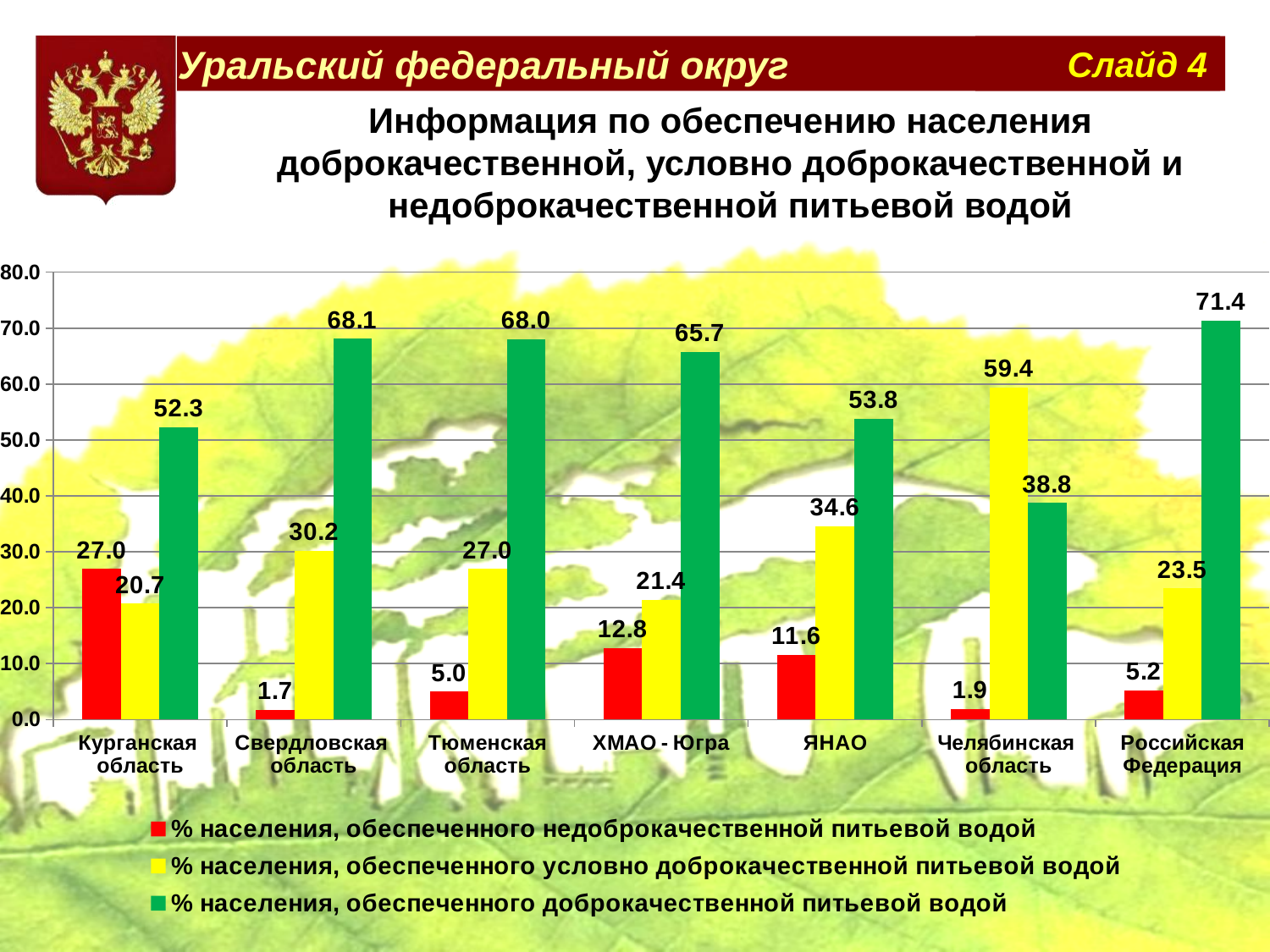
How many series does the chart legend list? 3 Is the value for Тюменская область in the series '% населения, обеспеченного доброкачественной питьевой водой' greater or less than 60.0? greater What is the value for ХМАО - Югра in the series '% населения, обеспеченного недоброкачественной питьевой водой'? 12.8 How many regions (categories) are shown on the x axis of the chart? 7 What colour represents the series '% населения, обеспеченного недоброкачественной питьевой водой' in the chart? red What is the value for Курганская область in the series '% населения, обеспеченного доброкачественной питьевой водой'? 52.3 What is the value for Челябинская область in the series '% населения, обеспеченного условно доброкачественной питьевой водой'? 59.4 Which category has the highest value in the series '% населения, обеспеченного доброкачественной питьевой водой'? Российская Федерация Which is larger: the '% населения, обеспеченного условно доброкачественной питьевой водой' value for ЯНАО or for Свердловская область? ЯНАО What type of chart is shown on the slide? bar chart What is the difference between the '% населения, обеспеченного доброкачественной питьевой водой' values for Российская Федерация and Челябинская область? 32.6 Which category has the lowest value in the series '% населения, обеспеченного недоброкачественной питьевой водой'? Свердловская область